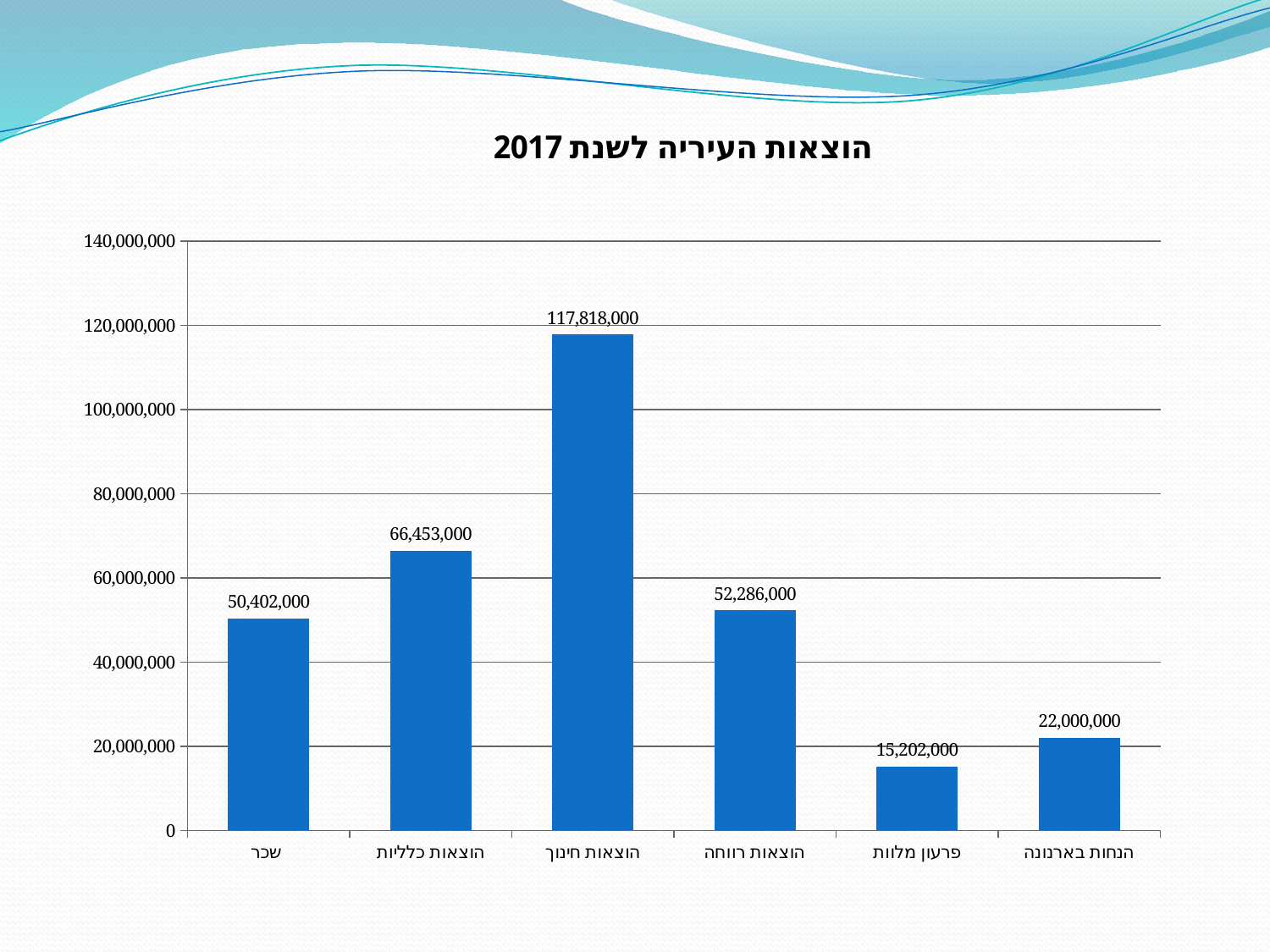
What is the difference between הנחות בארנונה and פרעון מלוות? 6,798,000 What is the value for פרעון מלוות? 15,202,000 Which category has the lowest value? פרעון מלוות What is the value for שכר? 50,402,000 Which category has the highest value? הוצאות חינוך What is the value for הנחות בארנונה? 22,000,000 What type of chart is shown on the slide? bar chart What is the value for הוצאות חינוך? 117,818,000 What is the difference between הוצאות חינוך and הוצאות כלליות? 51,365,000 How many categories are shown in the chart? 6 Which is larger, הוצאות כלליות or הוצאות רווחה? הוצאות כלליות Is the value for הוצאות רווחה greater or less than 60,000,000? less